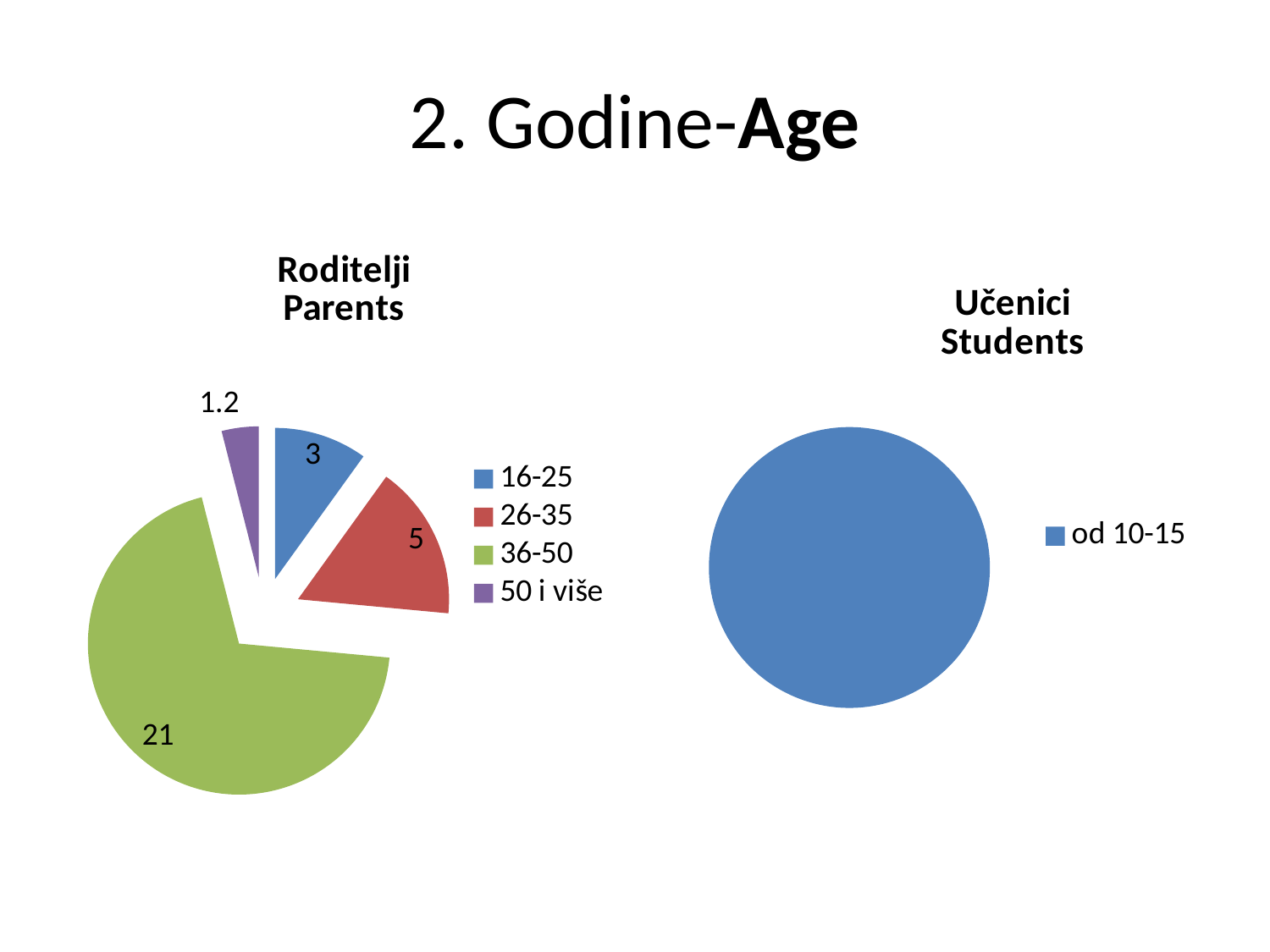
In the Roditelji Parents chart, what is the value for the 36-50 slice? 21 In the Roditelji Parents chart, what is the value for the 26-35 slice? 5 In the Roditelji Parents chart, what is the value for the 16-25 slice? 3 In the Roditelji Parents chart, which age group has the smallest slice? 50 i više In the Roditelji Parents chart, which is larger, the value for 26-35 or the value for 16-25? 26-35 In the Roditelji Parents chart, what is the value for the 50 i više slice? 1.2 In the Roditelji Parents chart, which age group has the largest slice? 36-50 What is the legend entry of the Učenici Students chart? od 10-15 How many slices does the Roditelji Parents chart have? 4 What kind of chart is the Učenici Students chart? Pie chart In the Roditelji Parents chart, what is the difference between the values for 36-50 and 26-35? 16 How many entries does the legend of the Učenici Students chart list? 1